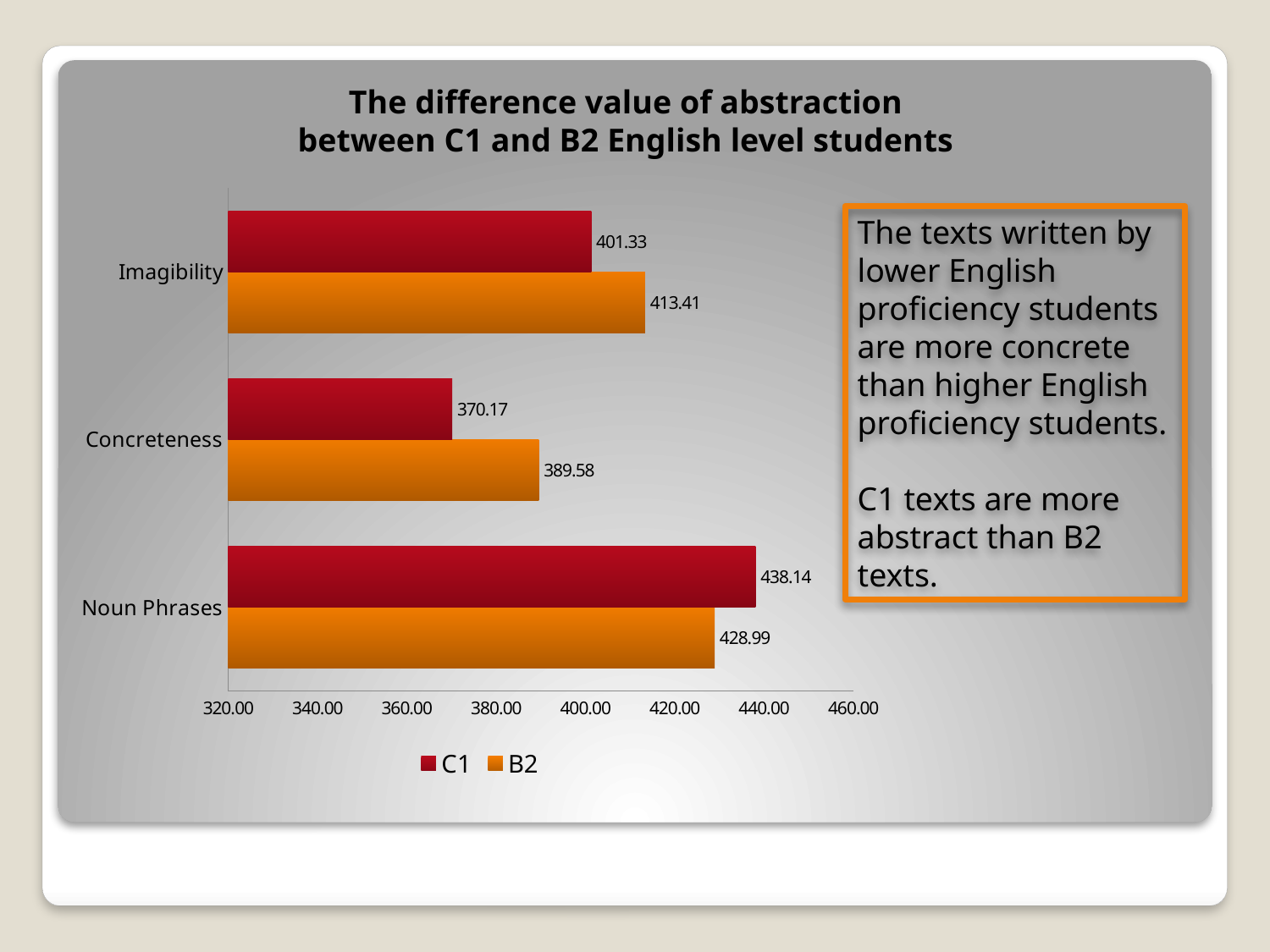
Which category has the lowest B2 value? Concreteness What is the C1 value for Imagibility? 401.33 How many categories are shown on the chart? 3 Which category has the highest C1 value? Noun Phrases What is the difference between the B2 and C1 values for Concreteness? 19.41 How many series does the legend list? 2 What is the B2 value for Noun Phrases? 428.99 For Imagibility, which series has the larger value, C1 or B2? B2 What is the difference between the C1 and B2 values for Noun Phrases? 9.15 What type of chart is shown on the slide? Bar chart What is the B2 value for Concreteness? 389.58 Is the C1 value for Concreteness greater or less than 380.00? less